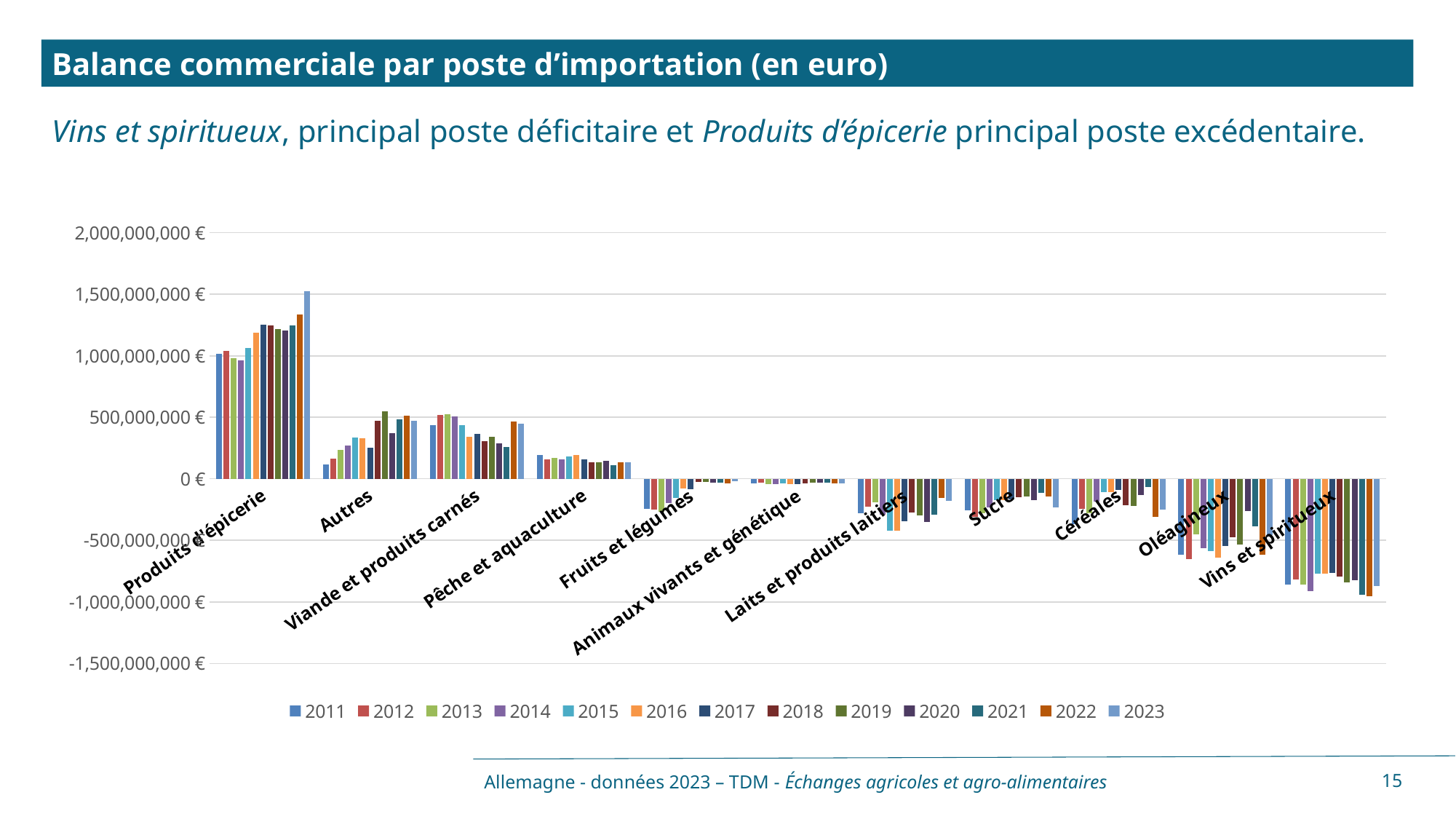
How many import categories are shown along the x axis? 11 Is the 2022 value for Produits d'épicerie greater or less than 1,000,000,000 €? greater Do the values for Produits d'épicerie generally rise or fall from 2011 to 2023? rise How many series (years) does the legend list? 13 Which category has the highest value for 2023? Produits d'épicerie For 2021, which category has the lower value: Oléagineux or Vins et spiritueux? Vins et spiritueux For Produits d'épicerie, which is larger: the 2011 value or the 2023 value? 2023 What kind of chart is shown on the slide? bar chart What is the title of the chart on the slide? Balance commerciale par poste d'importation (en euro) Is the 2021 value for Vins et spiritueux greater or less than -500,000,000 €? less Is the 2011 value for Autres greater or less than 500,000,000 €? less Which category has the lowest (most negative) value for 2023? Vins et spiritueux